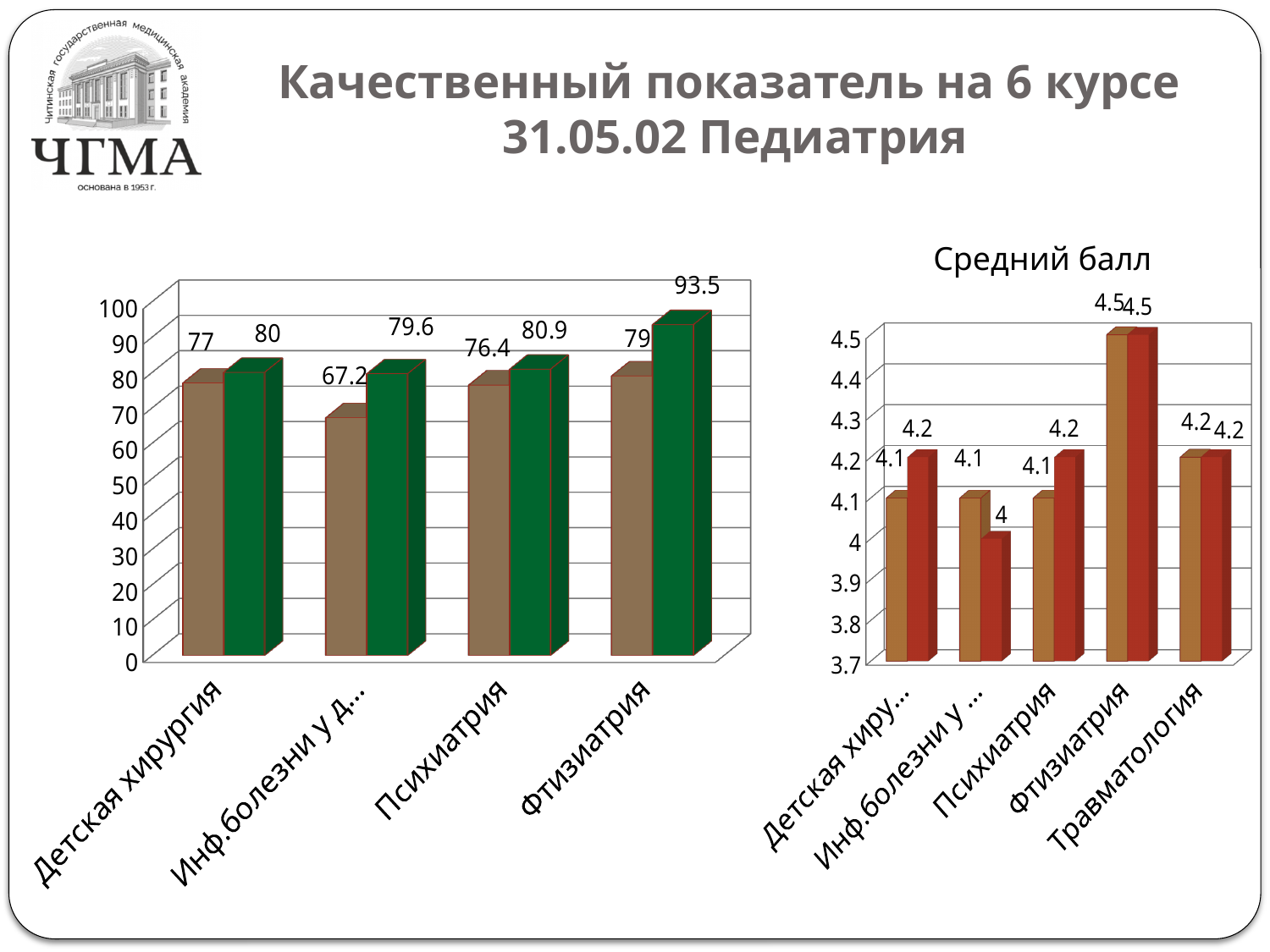
On the left chart, what is the value of the green bar for Фтизиатрия? 93.5 On the chart titled Средний балл, what is the value of the red bar for Фтизиатрия? 4.5 On the chart titled Средний балл, what is the value of the brown bar for Травматология? 4.2 On the left chart, is the brown bar for Психиатрия greater or less than 70? greater On the left chart, what is the difference between the green and brown bars for Фтизиатрия? 14.5 On the chart titled Средний балл, which category has the highest brown bar? Фтизиатрия On the left chart, which category has the highest green bar? Фтизиатрия On the left chart, what is the value of the green bar for Психиатрия? 80.9 What type of chart is the chart titled Средний балл? Bar chart On the left chart, what is the value of the brown bar for Детская хирургия? 77 On the left chart, how many categories are shown on the x axis? 4 On the chart titled Средний балл, how many categories are shown on the x axis? 5